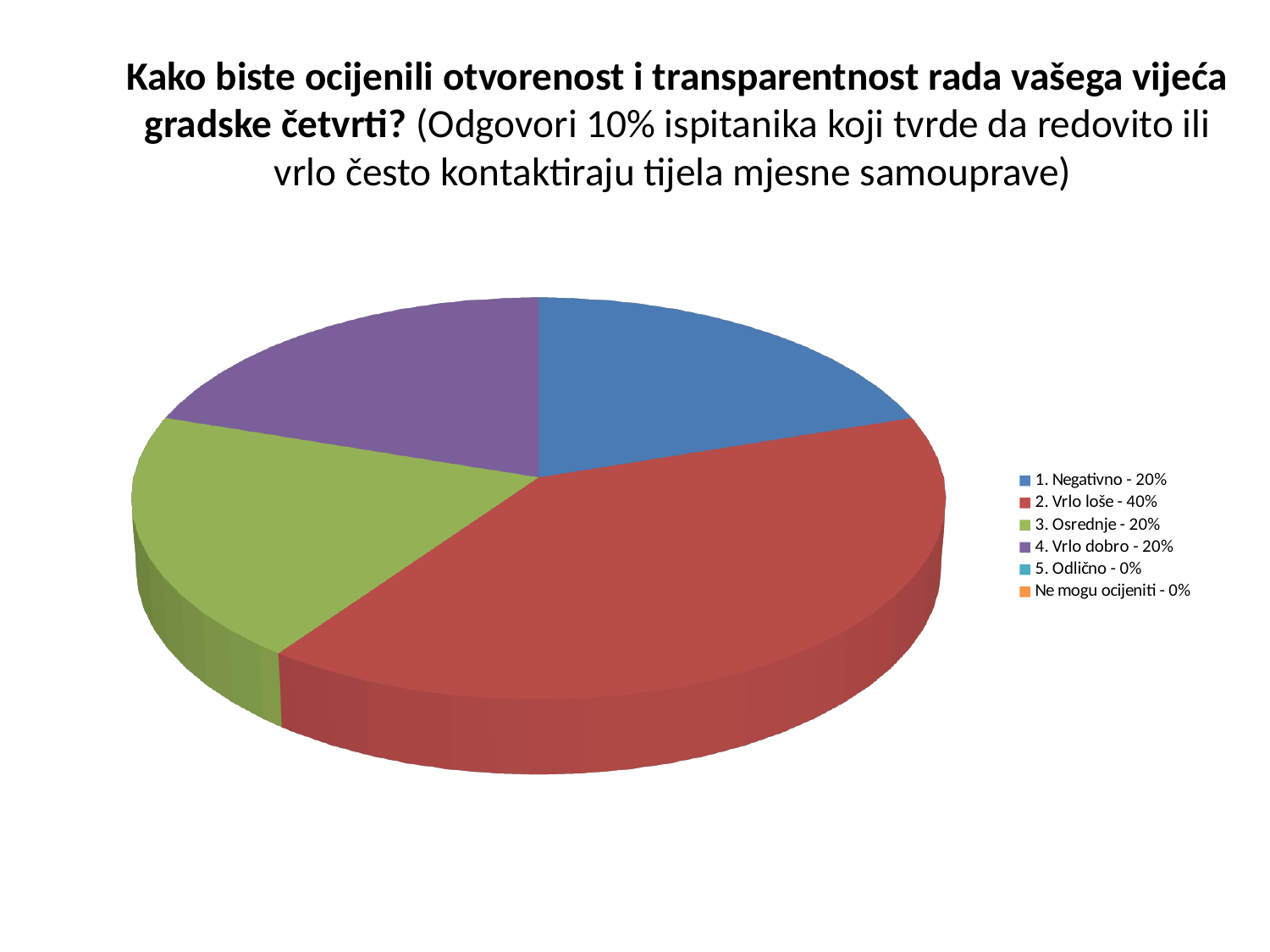
What share of respondents answered "4. Vrlo dobro"? 20% How many categories in the legend have a share of 0%? 2 What kind of chart is shown on the slide? pie chart What share of respondents answered "2. Vrlo loše"? 40% What colour is the slice for "2. Vrlo loše"? red What share of respondents answered "5. Odlično"? 0% Which category has the largest share of the pie? 2. Vrlo loše Which is larger, the share for "2. Vrlo loše" or the share for "3. Osrednje"? 2. Vrlo loše What is the difference between the share for "2. Vrlo loše" and the share for "1. Negativno"? 20% How many categories does the legend list? 6